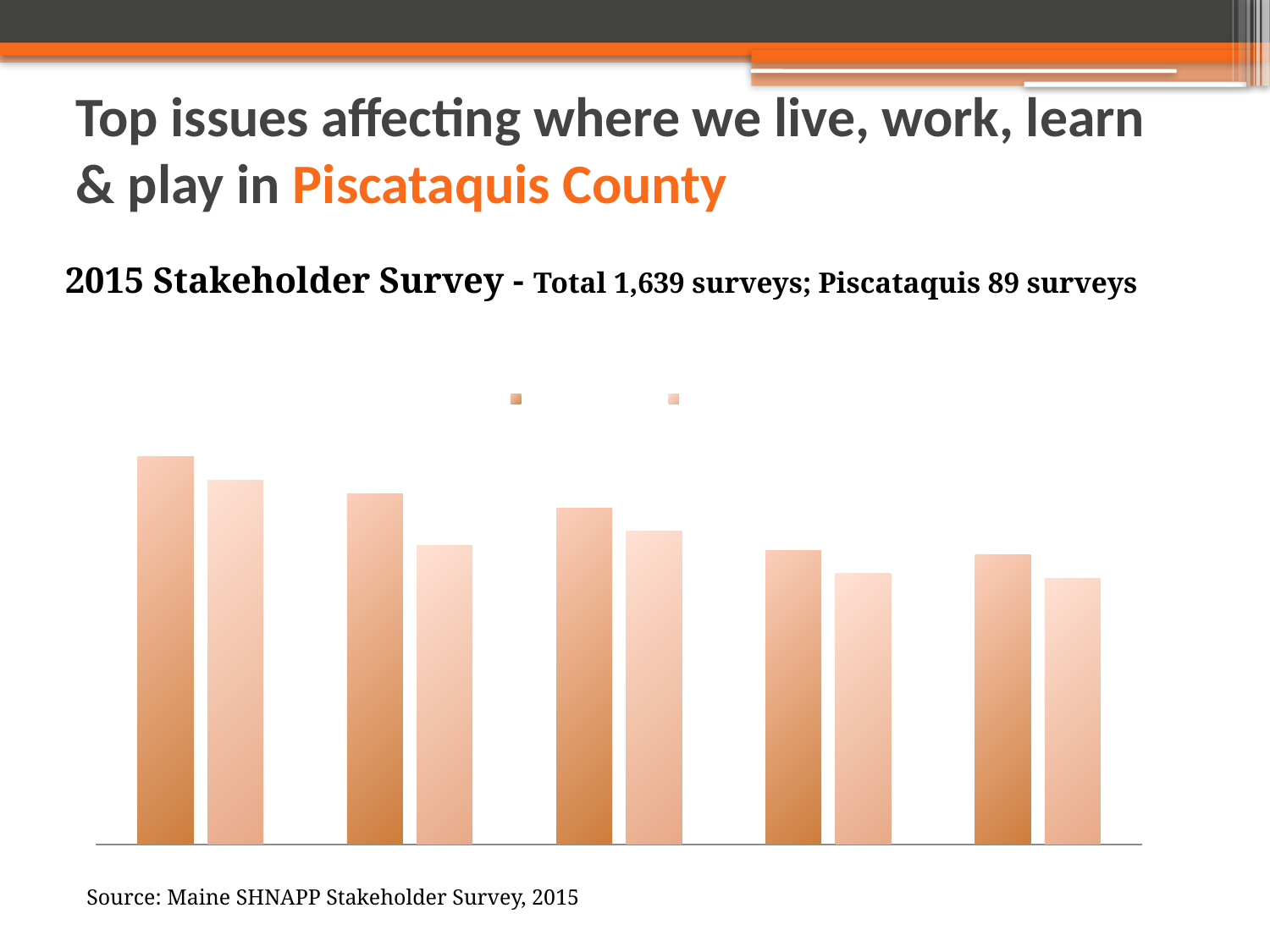
What colours are used for the two series in the chart? dark orange and light orange Which group of bars is the tallest in the chart? the leftmost group Do the bar heights generally rise or fall from left to right across the chart? fall How many series does the chart's legend list? 2 In the leftmost group, is the darker orange bar taller or shorter than the lighter orange bar? taller What kind of chart is shown on the slide? bar chart How many groups of bars (categories) are plotted in the chart? 5 In each group, which bar is taller: the darker orange bar or the lighter orange bar? the darker orange bar How many bars are plotted in total on the chart? 10